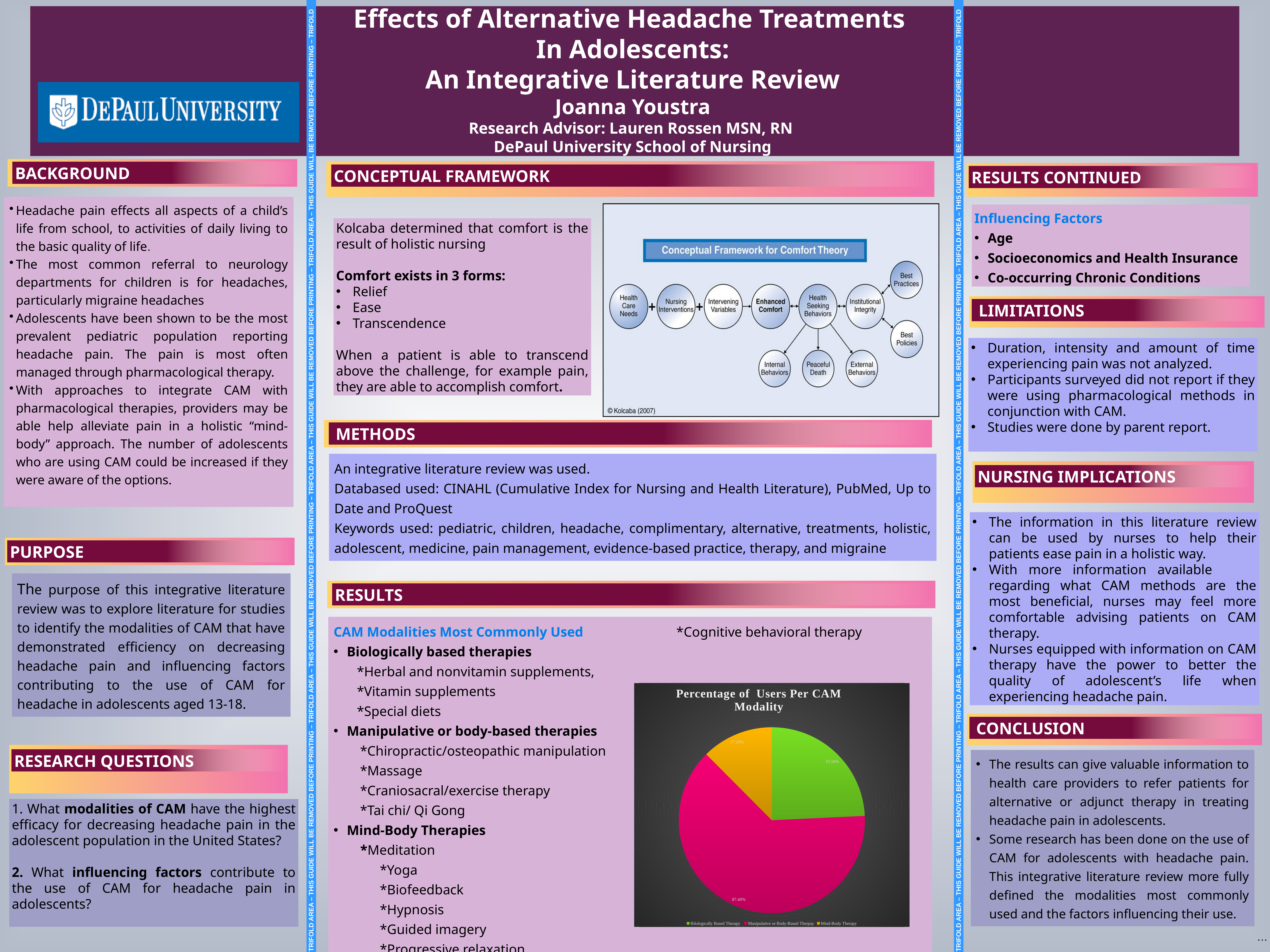
What value is labelled on the Manipulative or Body-Based Therapy slice of the pie chart? 87.40% What colour is the Manipulative or Body-Based Therapy slice in the pie chart? pink Which CAM modality has the largest slice in the pie chart? Manipulative or Body-Based Therapy How many slices does the pie chart have? 3 What value is labelled on the Biologically Based Therapy slice of the pie chart? 33.50% What value is labelled on the Mind-Body Therapy slice of the pie chart? 17.20% How many entries does the pie chart's legend list? 3 What is the difference between the labelled values for Manipulative or Body-Based Therapy and Biologically Based Therapy in the pie chart? 53.90% In the pie chart, which is larger: the Biologically Based Therapy slice or the Mind-Body Therapy slice? Biologically Based Therapy What is the title of the pie chart? Percentage of Users Per CAM Modality Which CAM modality has the smallest slice in the pie chart? Mind-Body Therapy What kind of chart is shown under the Results section? pie chart